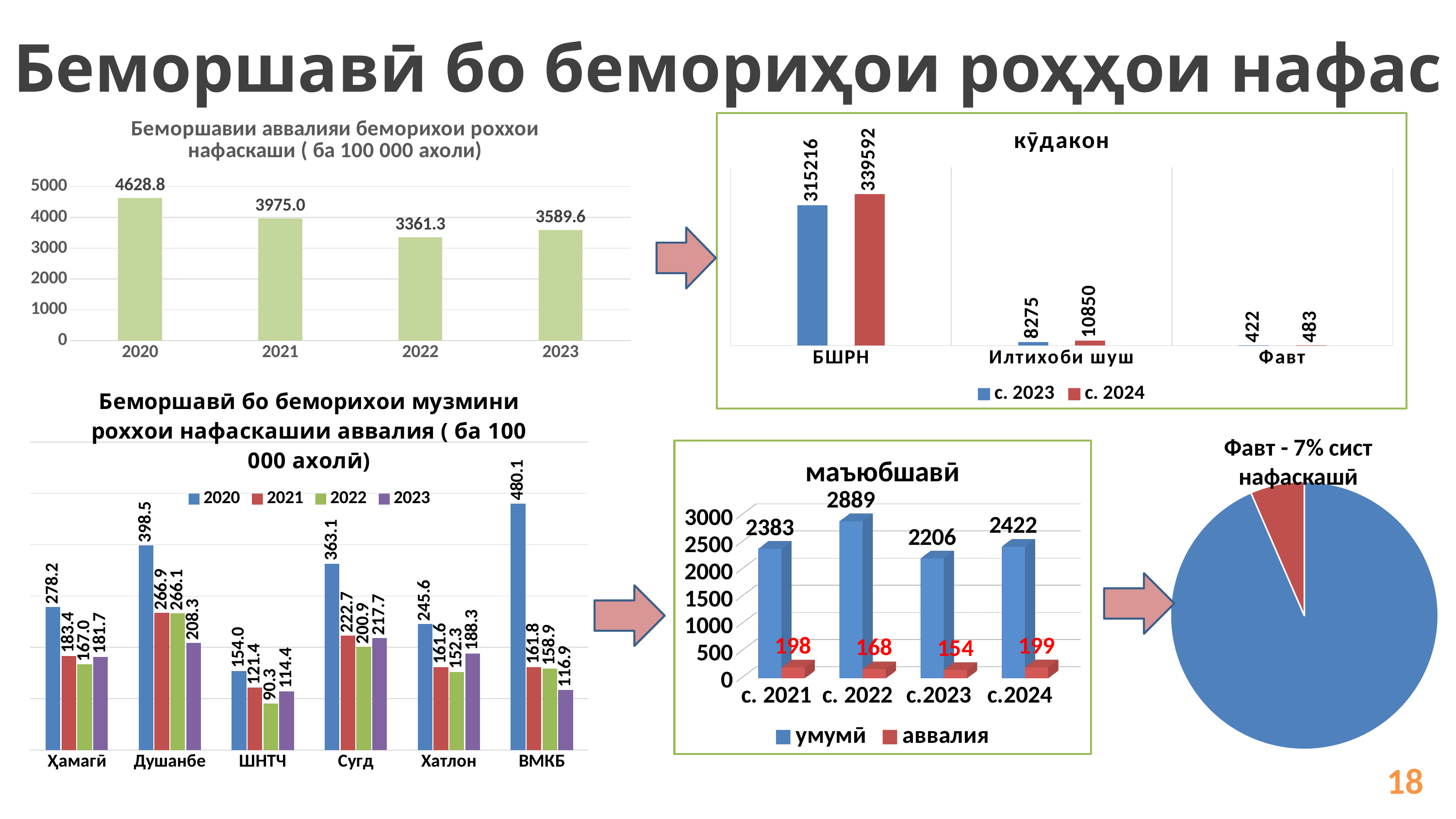
In the top-left chart 'Беморшавии аввалияи беморихои роххои нафаскаши', which year has the lowest value? 2022 In the bottom-right chart 'маъюбшавӣ', what is the аввалия value for с.2023? 154 In the top-right chart 'кӯдакон', what is the difference between the с. 2024 and с. 2023 values for Илтихоби шуш? 2575 In the bottom-left chart 'Беморшавӣ бо беморихои музмини роххои нафаскашии аввалия', what is the 2020 value for ВМКБ? 480.1 In the bottom-right chart 'маъюбшавӣ', which year has the highest умумӣ value? с. 2022 In the top-left chart 'Беморшавии аввалияи беморихои роххои нафаскаши', what is the difference between the 2020 and 2021 values? 653.8 In the bottom-left chart 'Беморшавӣ бо беморихои музмини роххои нафаскашии аввалия', how many series does the legend list? 4 What kind of chart is the chart titled 'Фавт - 7% сист нафаскашӣ'? pie chart In the top-left chart 'Беморшавии аввалияи беморихои роххои нафаскаши', how many years are shown? 4 In the top-right chart 'кӯдакон', what is the с. 2024 value for БШРН? 339592 In the bottom-left chart 'Беморшавӣ бо беморихои музмини роххои нафаскашии аввалия', which region has the lowest 2022 value? ШНТЧ In the top-left chart 'Беморшавии аввалияи беморихои роххои нафаскаши', what is the value for 2020? 4628.8